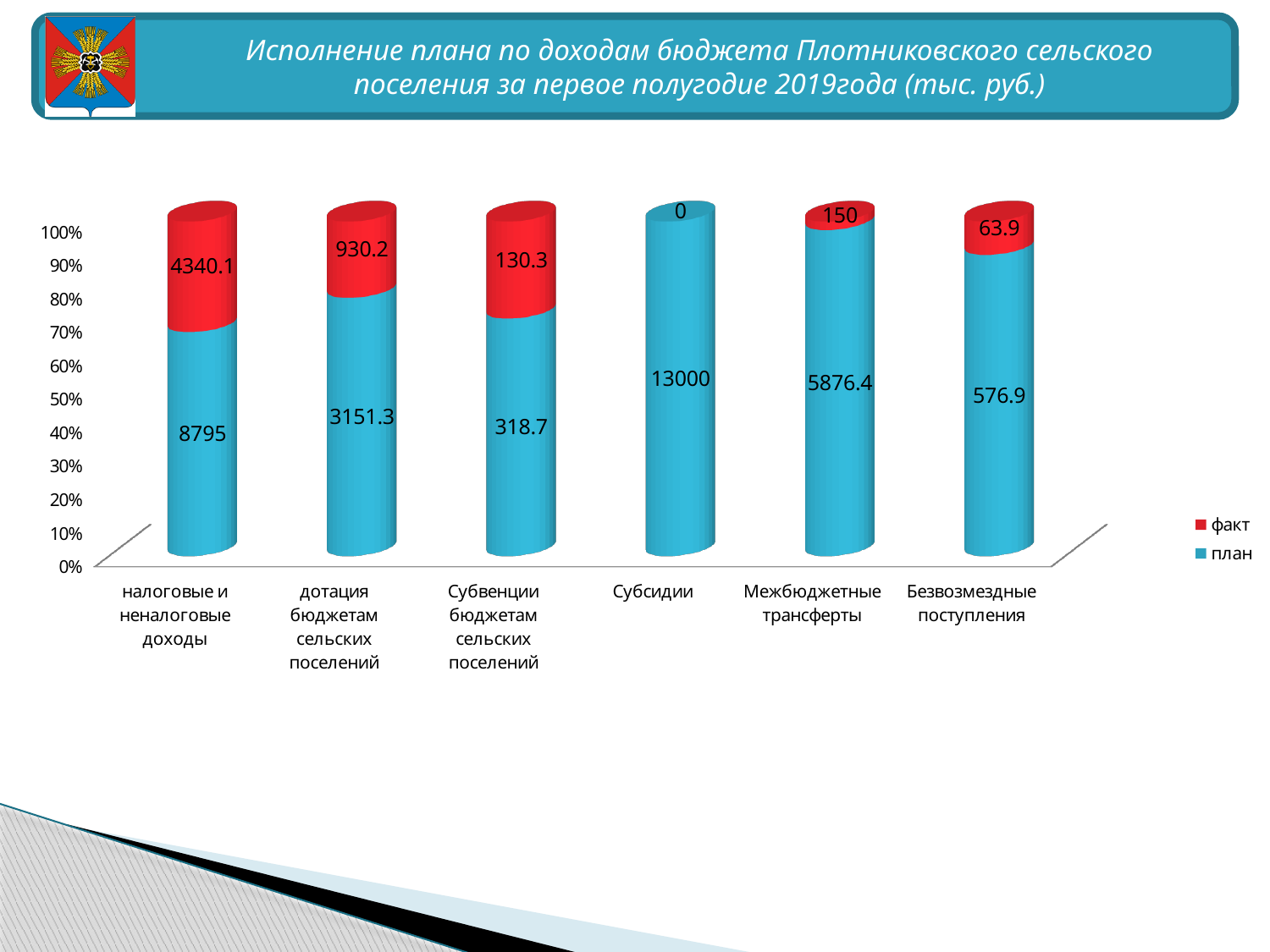
Which category has the highest план value? Субсидии Which category has the lowest факт value? Субсидии Which is larger: the план value for дотация бюджетам сельских поселений or for Межбюджетные трансферты? Межбюджетные трансферты What kind of chart is shown on the slide? Stacked bar chart What is the факт value for дотация бюджетам сельских поселений? 930.2 How many categories are shown on the x axis? 6 What is the план value for налоговые и неналоговые доходы? 8795 How many series does the legend list? 2 What is the факт value for Межбюджетные трансферты? 150 What is the план value for Субсидии? 13000 What is the difference between the план and факт values for налоговые и неналоговые доходы? 4454.9 Which colour represents the факт series in the legend? Red